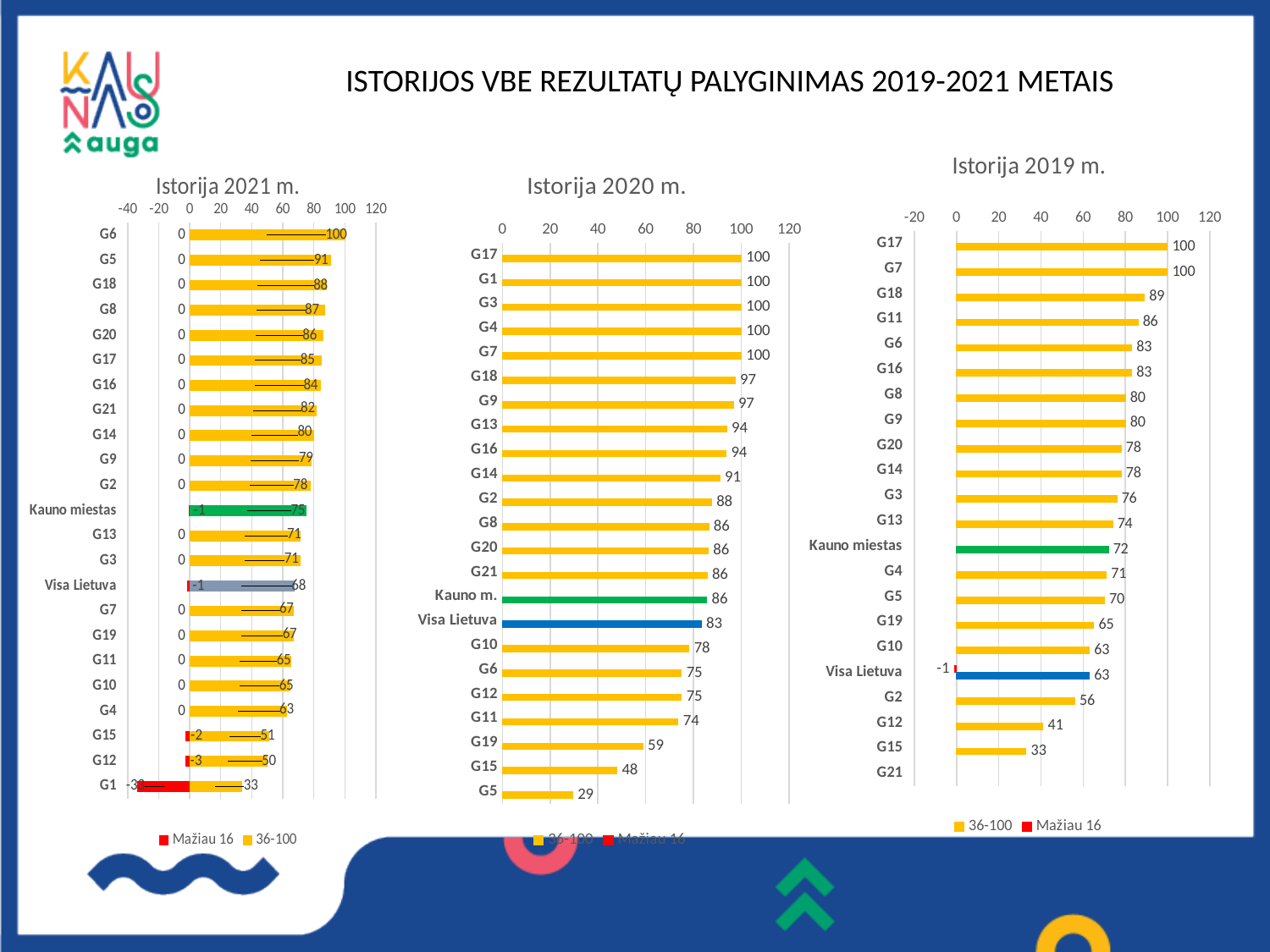
In the 'Istorija 2020 m.' chart, what is the difference between the values for G17 and G11? 26 In the 'Istorija 2020 m.' chart, which is larger, the value for G19 or the value for G15? G19 In the 'Istorija 2021 m.' chart, which category has the lowest 36-100 value? G1 In the 'Istorija 2021 m.' chart, what is the difference between the 36-100 values for G5 and G12? 41 In the 'Istorija 2019 m.' chart, which is larger, the value for G2 or the value for G12? G2 In the 'Istorija 2019 m.' chart, what is the 36-100 value for G18? 89 In the 'Istorija 2020 m.' chart, what is the value for Visa Lietuva? 83 In the 'Istorija 2020 m.' chart, what is the value for G5? 29 In the 'Istorija 2019 m.' chart, what is the 36-100 value for Kauno miestas? 72 What kind of chart is the 'Istorija 2020 m.' chart? Bar chart In the 'Istorija 2021 m.' chart, what is the 36-100 value for Kauno miestas? 75 In the 'Istorija 2021 m.' chart, what is the 36-100 value for G6? 100